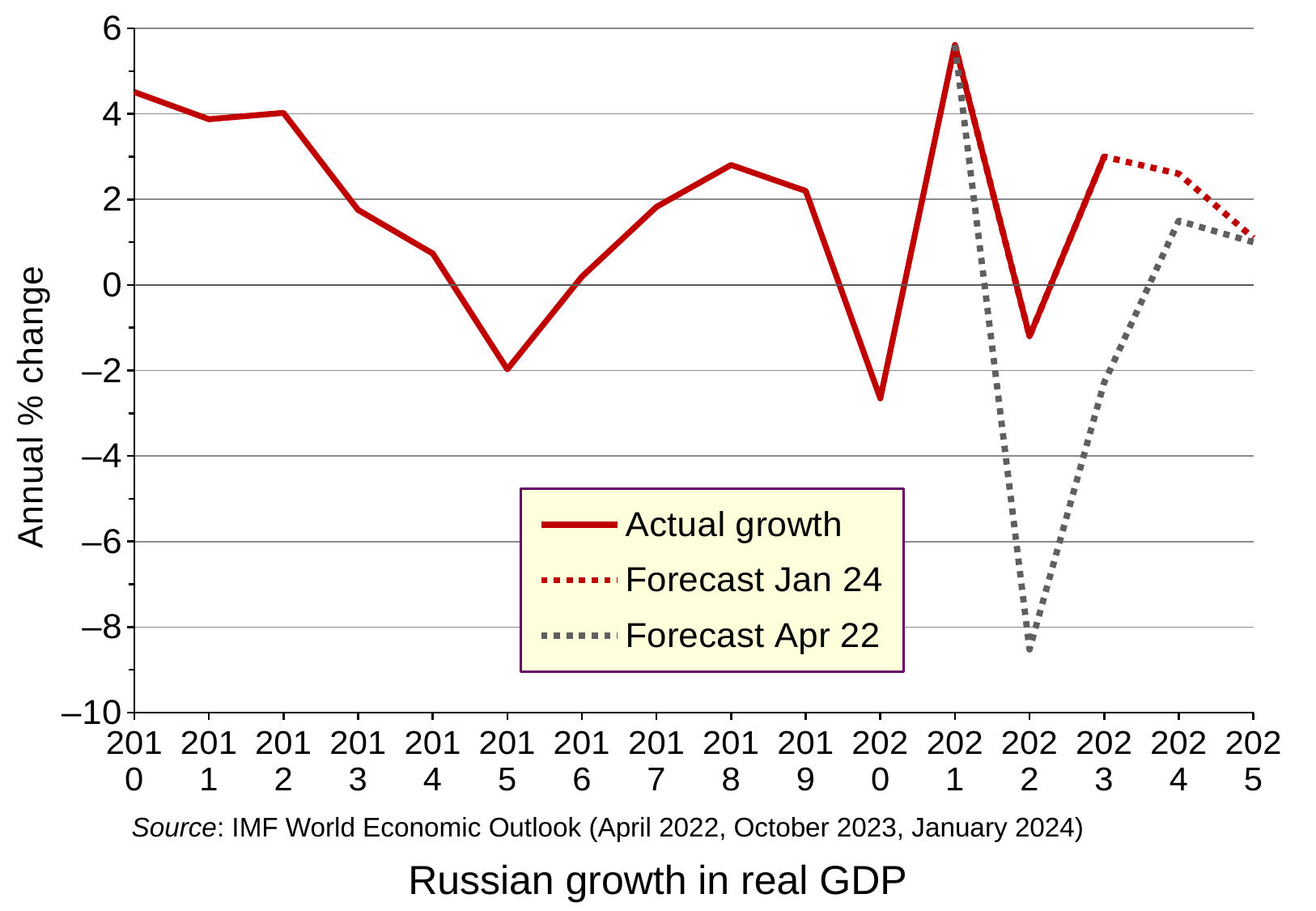
In which year does the Forecast Apr 22 series reach its lowest value? 2022 Does the Actual growth series rise or fall from 2010 to 2015? fall What kind of chart is shown on the slide? line chart Is the Forecast Apr 22 value for 2022 greater or less than -8? less What is the title of the chart? Russian growth in real GDP How many years are shown along the x axis? 16 Is the Actual growth value for 2015 greater or less than 0? less Is the Actual growth value for 2010 greater or less than 4? greater For 2022, which is higher: the Actual growth value or the Forecast Apr 22 value? Actual growth How many series does the legend list? 3 In which year does the Actual growth series reach its lowest value? 2020 In which year does the Actual growth series reach its highest value? 2021